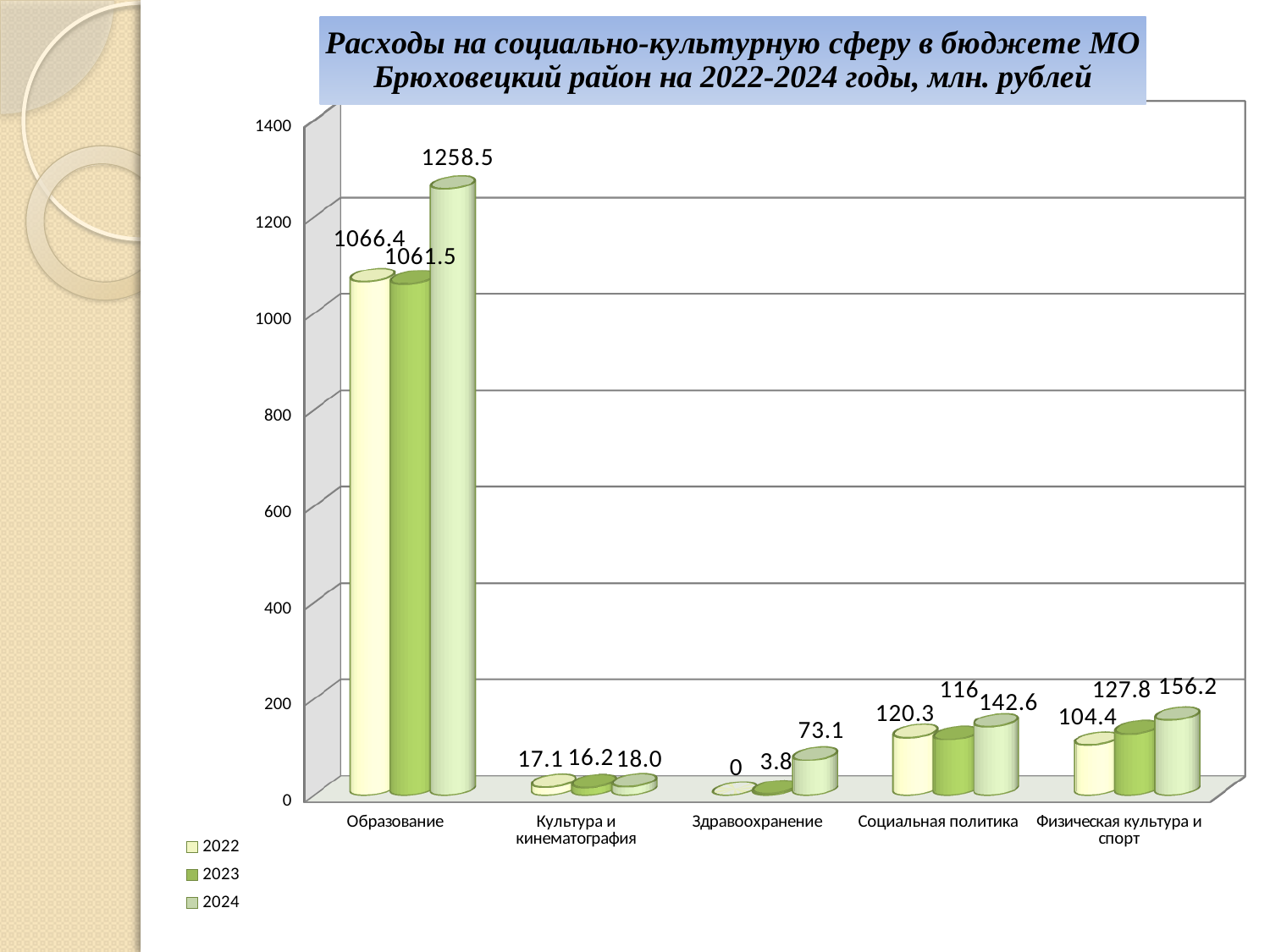
What is the value for Образование in 2024? 1258.5 What is the value for Социальная политика in 2022? 120.3 Which is larger for Физическая культура и спорт: the 2022 value or the 2023 value? 2023 How many categories are shown on the x axis? 5 Which category has the highest value in 2022? Образование What is the value for Физическая культура и спорт in 2024? 156.2 What is the difference between the 2024 and 2023 values for Образование? 197 How many series does the legend list? 3 Which category has the lowest value in 2023? Здравоохранение What kind of chart is shown on the slide? Bar chart What is the value for Здравоохранение in 2023? 3.8